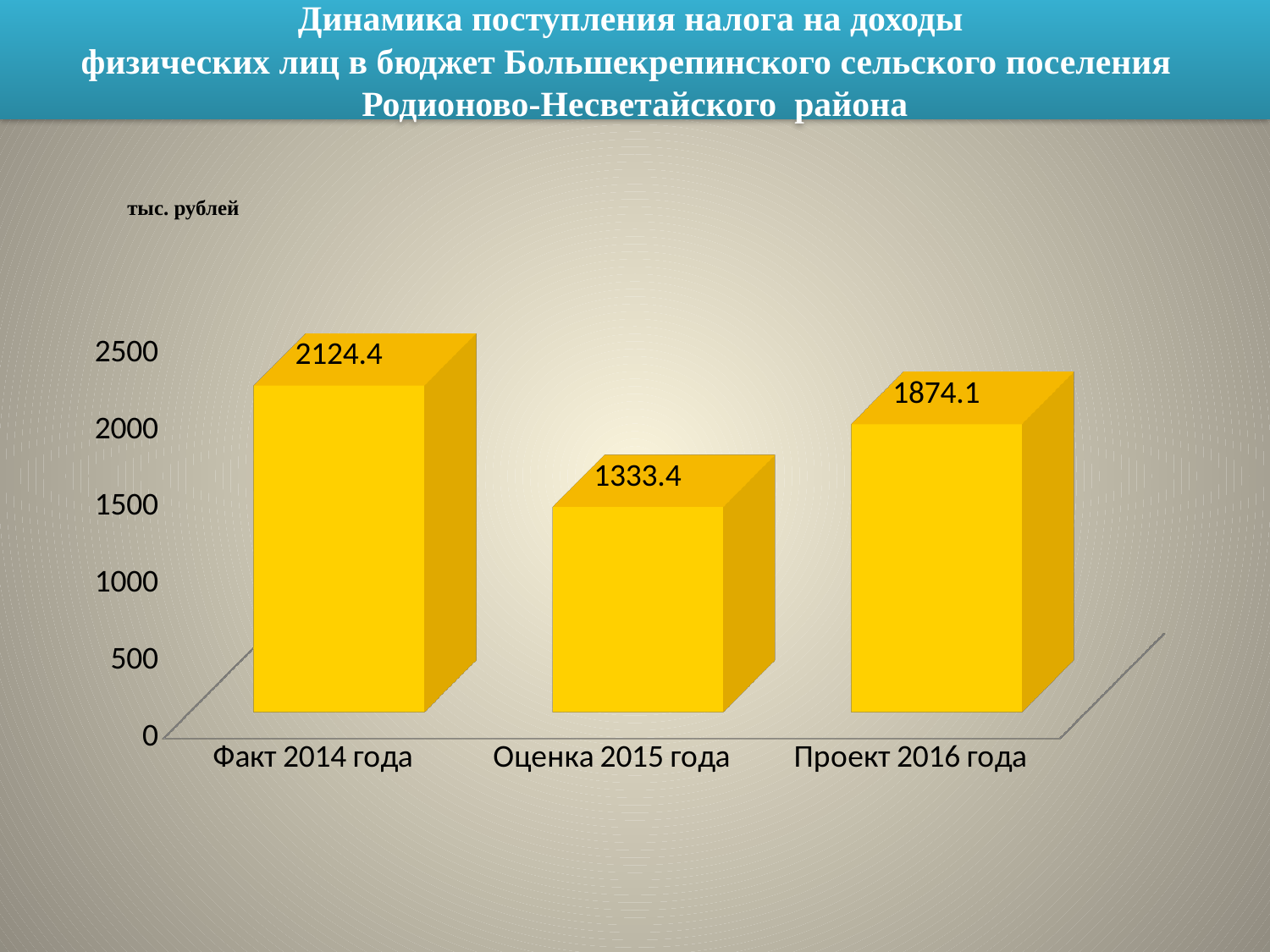
How many categories are shown on the chart? 3 Which category has the lowest value? Оценка 2015 года Which category has the highest value? Факт 2014 года What is the value for Факт 2014 года? 2124.4 Is the value for Оценка 2015 года greater or less than 1500? less What kind of chart is shown on the slide? bar chart What is the value for Оценка 2015 года? 1333.4 What is the value for Проект 2016 года? 1874.1 What is the difference between the values for Факт 2014 года and Оценка 2015 года? 791 What is the difference between the values for Проект 2016 года and Оценка 2015 года? 540.7 Does the value fall or rise from Факт 2014 года to Оценка 2015 года? fall Which is larger, the value for Проект 2016 года or the value for Оценка 2015 года? Проект 2016 года